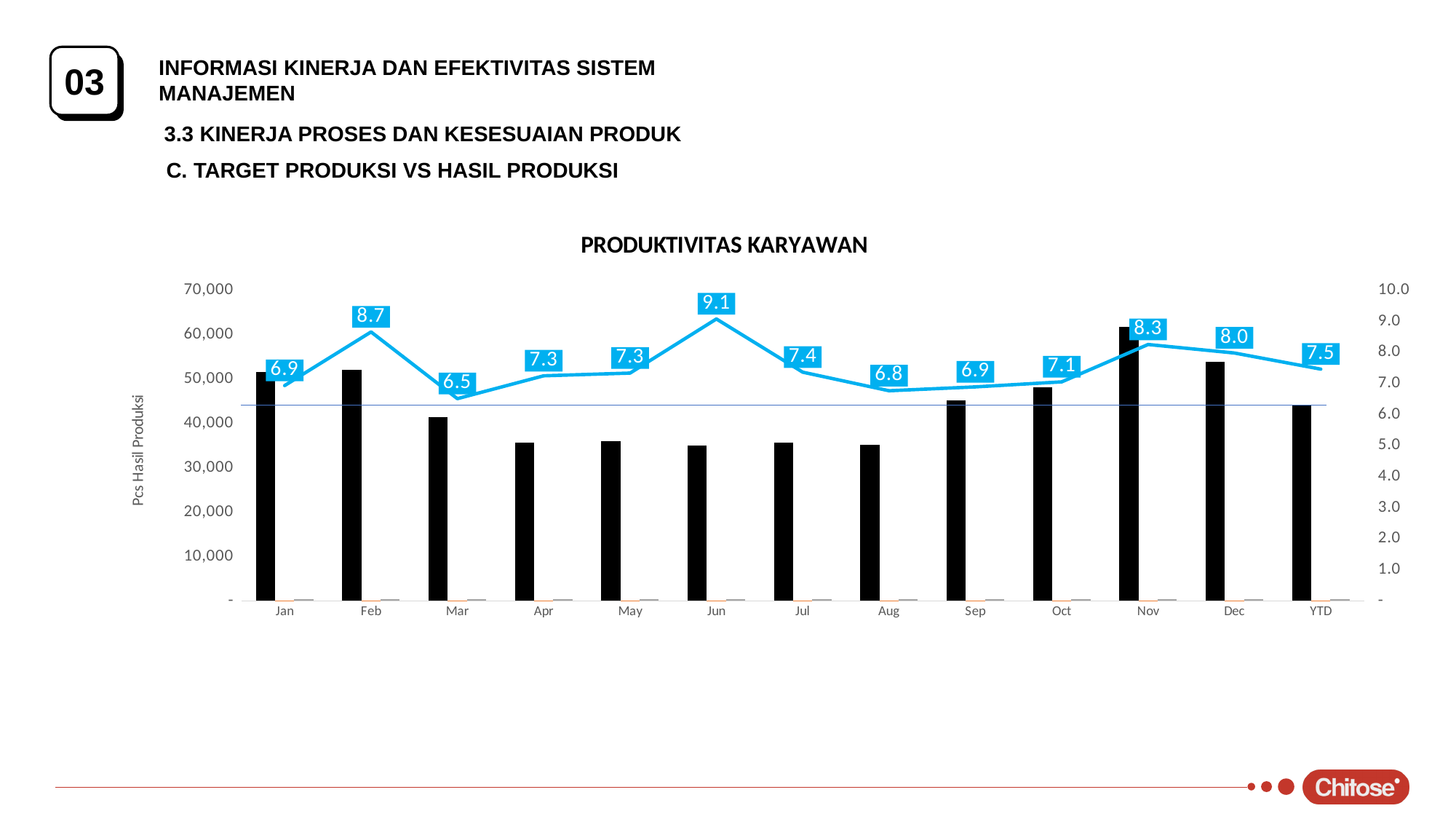
What is the productivity value shown on the line for Feb? 8.7 How many categories are shown on the x axis? 13 What kind of chart is this? Combination bar and line chart Is the bar value for Apr greater or less than 40,000? less Which month has the tallest black bar? Nov Which month has the lowest value on the productivity line? Mar What is the difference between the line values for Jun and Mar? 2.6 Which has a higher line value, Nov or Dec? Nov What is the productivity value shown on the line for YTD? 7.5 What is the title of the chart? PRODUKTIVITAS KARYAWAN What is the productivity value shown on the line for Jun? 9.1 Which month has the highest value on the productivity line? Jun